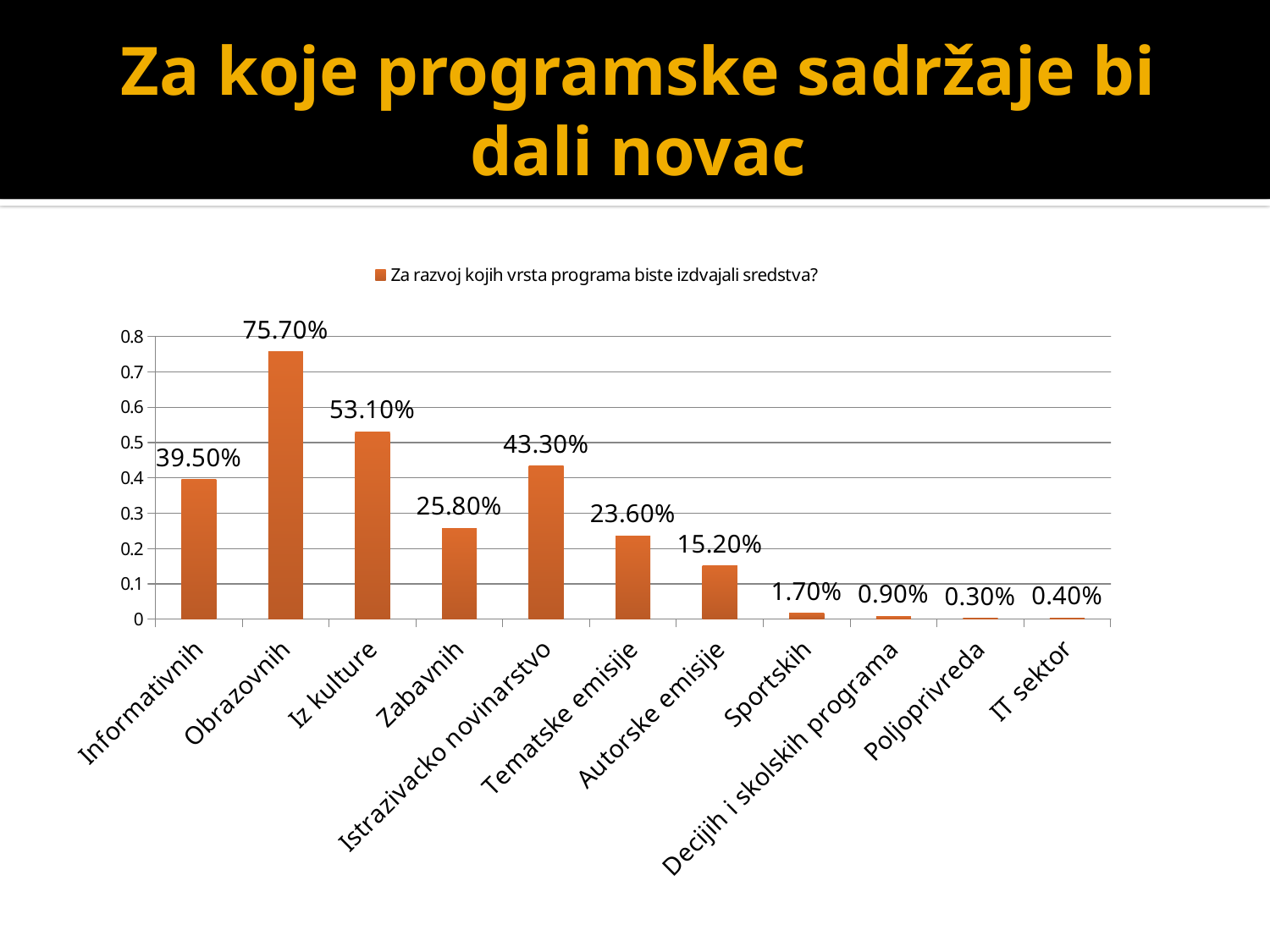
Which category has the lowest value? Poljoprivreda What is the difference between the values for Obrazovnih and Iz kulture? 22.60% How many series does the legend list? 1 Which is larger, the value for Zabavnih or the value for Tematske emisije? Zabavnih Is the value for Informativnih greater or less than 0.3? greater What is the value for Obrazovnih? 75.70% What is the value for Autorske emisije? 15.20% What is the legend entry for the series? Za razvoj kojih vrsta programa biste izdvajali sredstva? What is the value for Istrazivacko novinarstvo? 43.30% Which category has the highest value? Obrazovnih What kind of chart is shown on the slide? bar chart How many categories are shown on the x axis? 11